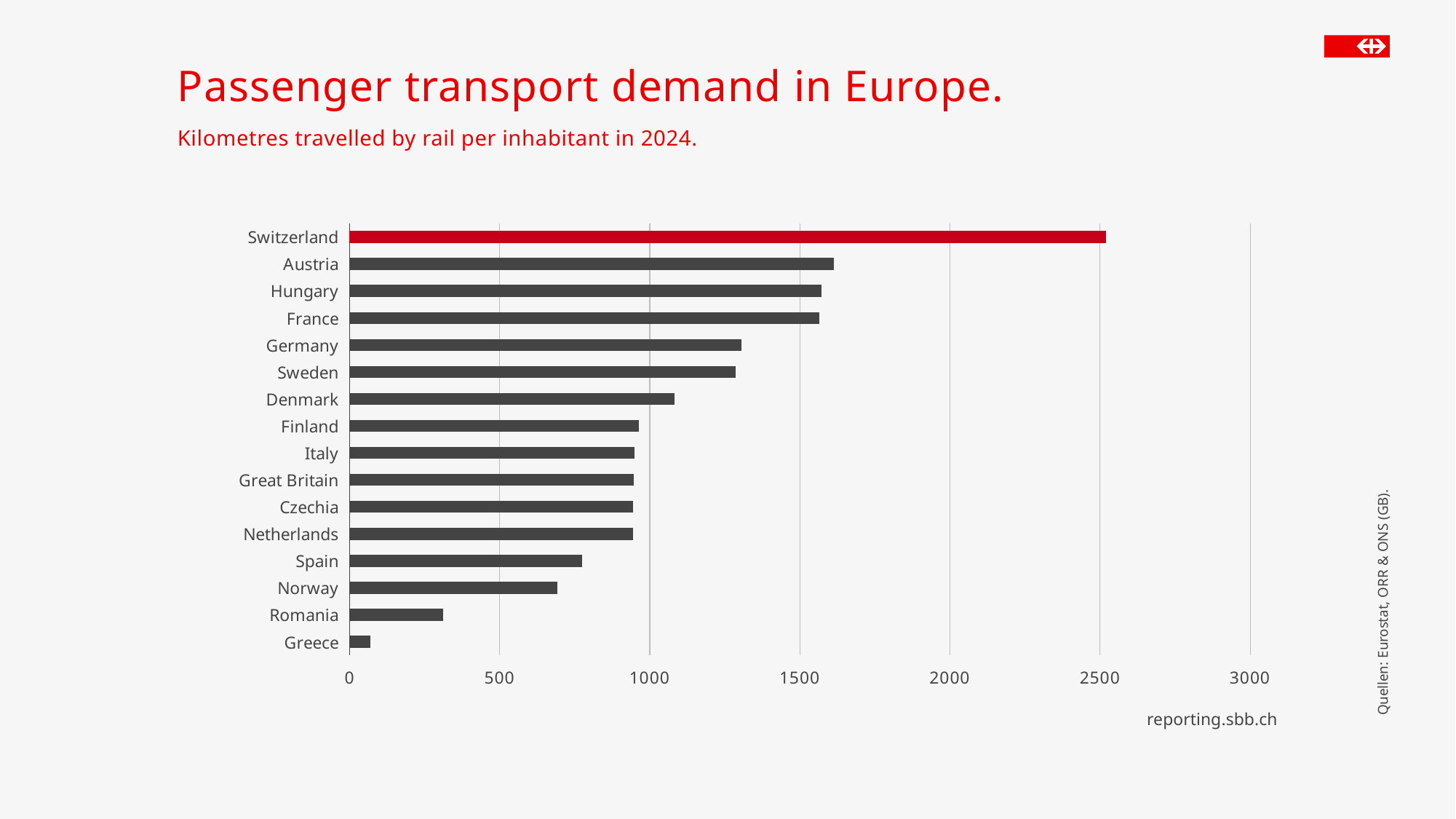
What kind of chart is shown on the slide? bar chart Is the value for Austria greater or less than 1500? greater Is the value for Switzerland greater or less than 2000? greater Is the value for Romania greater or less than 500? less Which country's bar is drawn in red rather than dark grey? Switzerland Which country has the lowest kilometres travelled by rail per inhabitant? Greece Which is larger, the value for Spain or the value for Norway? Spain Which country has the highest kilometres travelled by rail per inhabitant? Switzerland How many countries are shown in the chart? 16 Do the bar values rise or fall going from the top of the chart to the bottom? fall